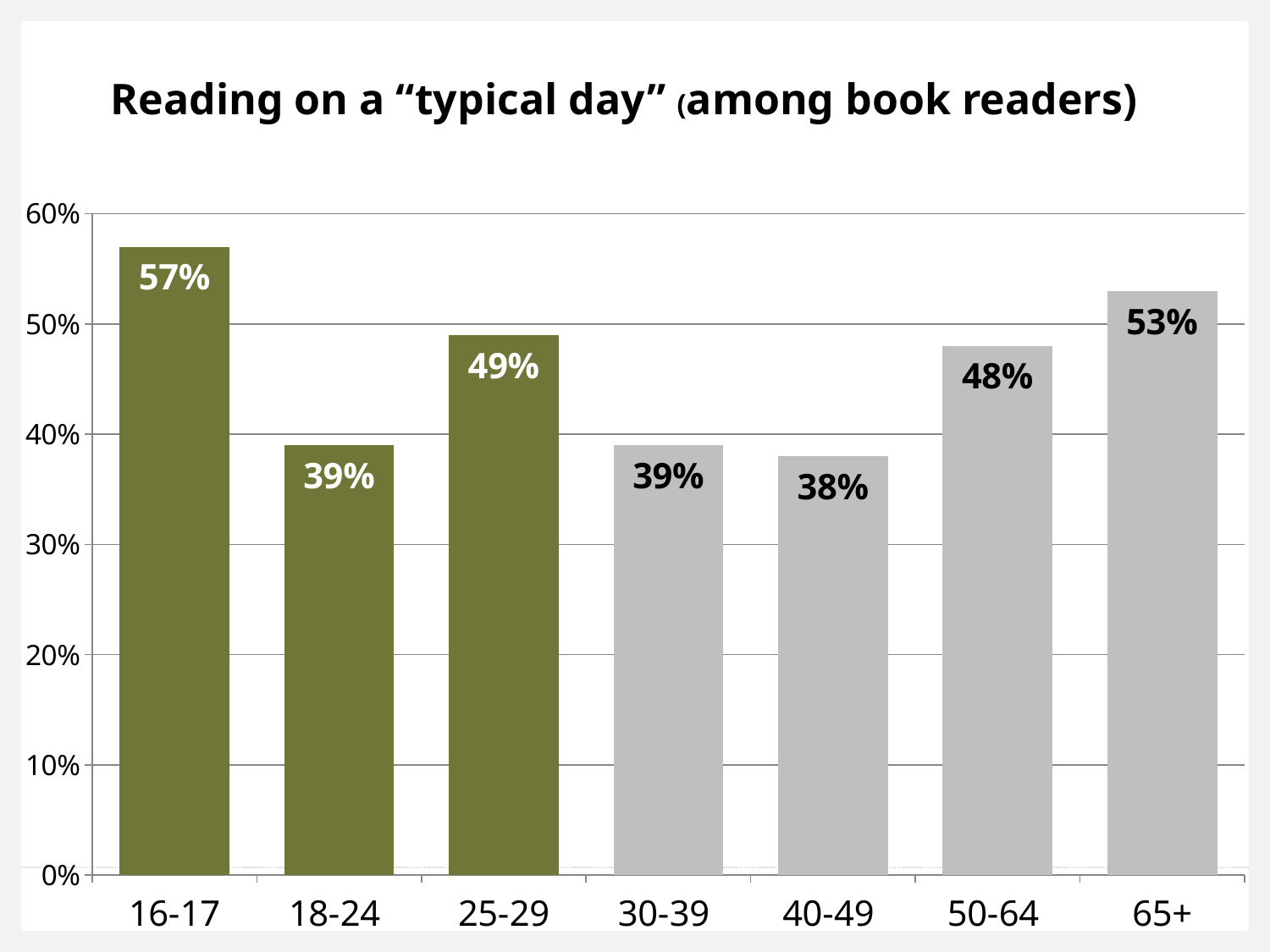
What is the title of the chart? Reading on a "typical day" (among book readers) What percentage of book readers aged 16-17 read on a typical day? 57% What is the difference between the values for 16-17 and 18-24? 18% What is the difference between the values for 65+ and 50-64? 5% What kind of chart is shown on the slide? bar chart Which age group has the highest value? 16-17 Is the value for 30-39 greater or less than 40%? less Which is larger, the value for 25-29 or the value for 50-64? 25-29 Which age group has the lowest value? 40-49 What is the value shown for the 65+ age group? 53% What is the value shown for the 40-49 age group? 38% How many age groups are shown on the x axis? 7